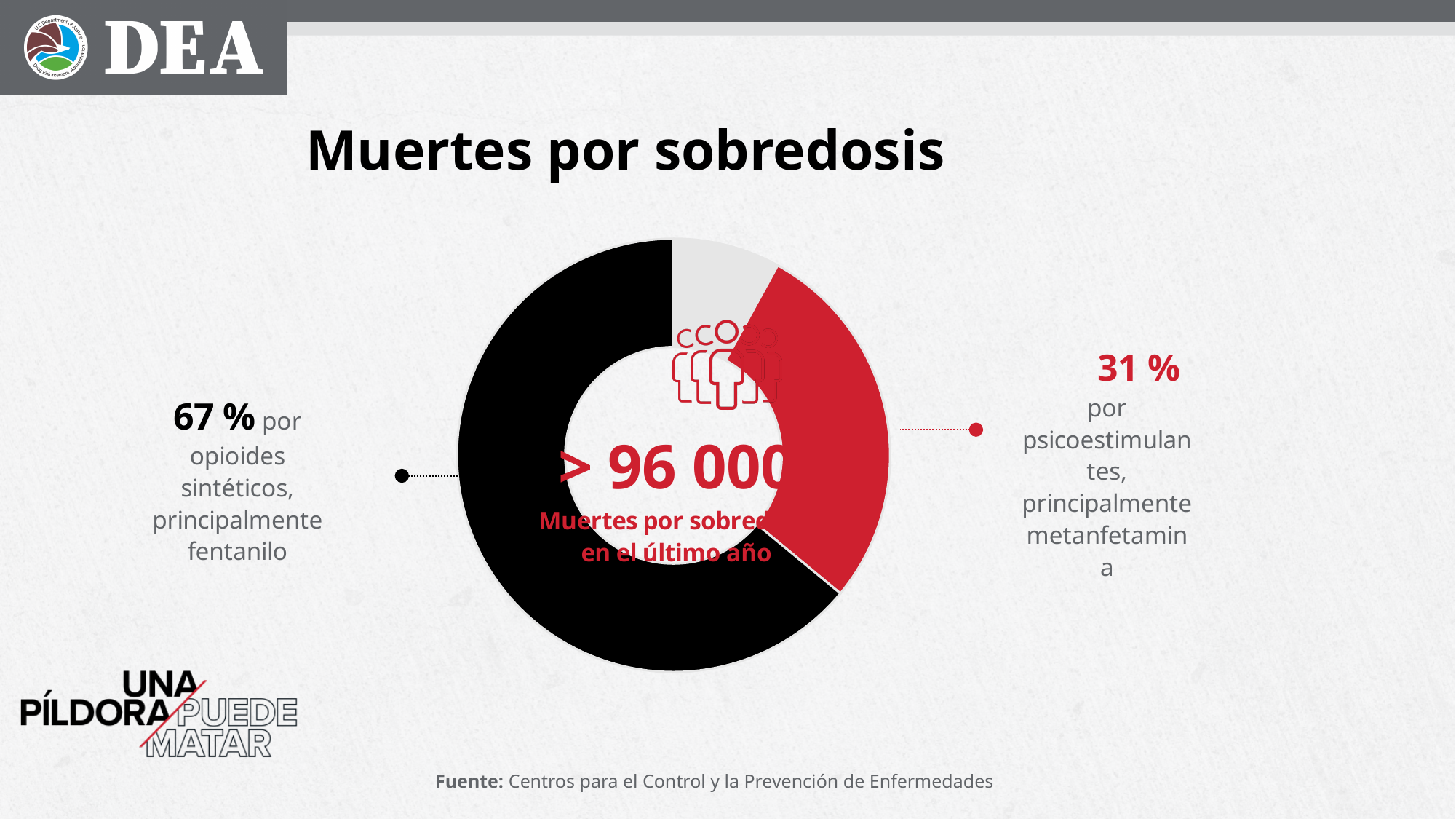
Which slice is the largest in the donut chart? Synthetic opioids, mainly fentanyl (67 %) By how many percentage points does the synthetic opioids share exceed the psychostimulants share? 36 percentage points What colour is the slice representing psychostimulants? Red What share of overdose deaths is attributed to synthetic opioids, mainly fentanyl? 67 % What share of overdose deaths is attributed to psychostimulants, mainly methamphetamine? 31 % What is the title of the slide's chart? Muertes por sobredosis How many slices does the donut chart have? 3 What is the total number of overdose deaths in the last year shown in the centre of the chart? > 96 000 What kind of chart is shown on the slide? Pie (donut) chart Is the share for psychostimulants greater or less than 50 %? less Which category accounts for the larger share of overdose deaths: synthetic opioids or psychostimulants? Synthetic opioids (opioides sintéticos)